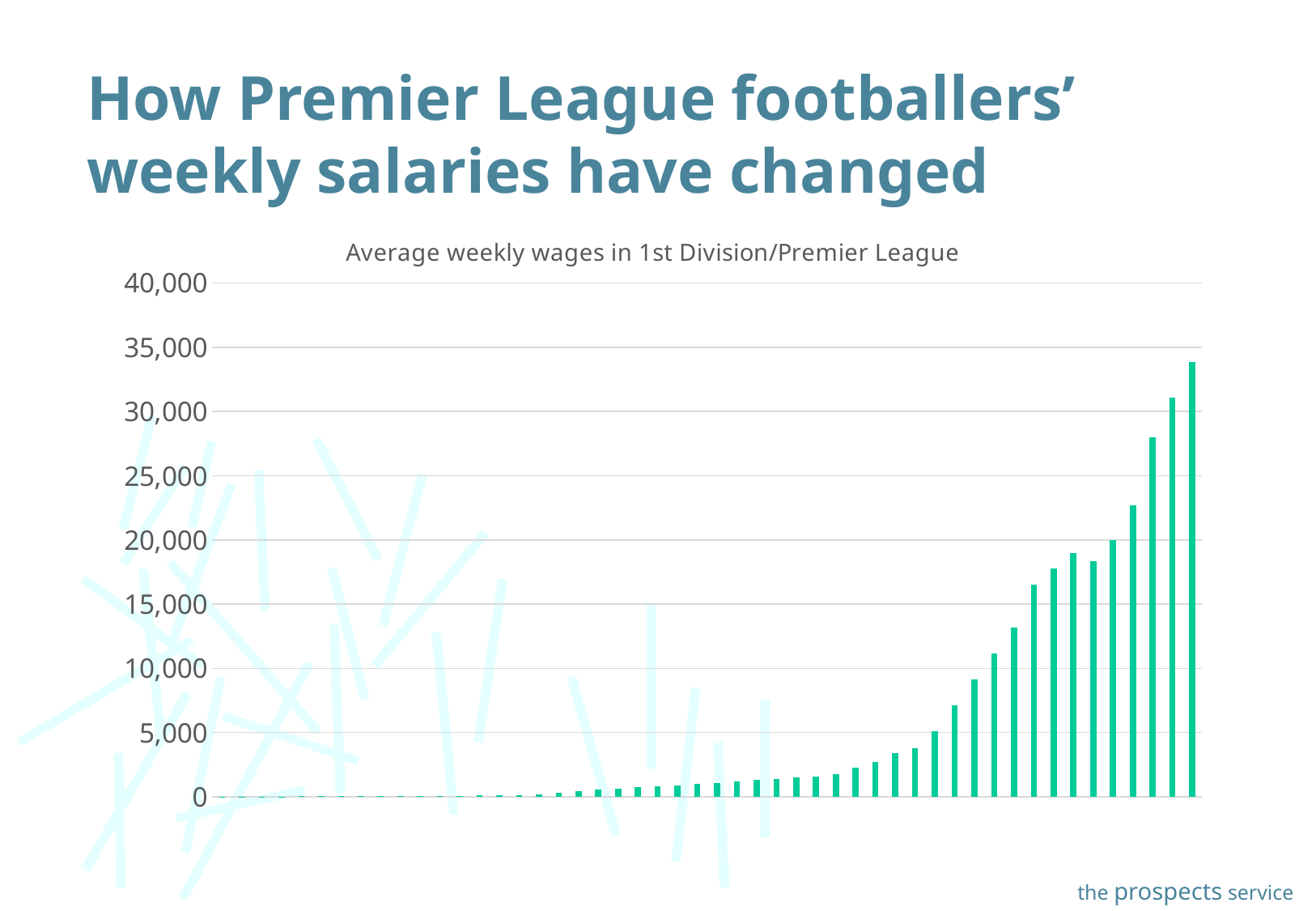
Do the values generally rise or fall from left to right along the x axis? rise What is the highest value shown on the y axis? 40,000 Is the value of the third bar from the right greater or less than 25,000? greater Is the value of the fourth bar from the right greater or less than 25,000? less Is the value of the rightmost bar greater or less than 35,000? less Which bar is the tallest: the leftmost bar or the rightmost bar? the rightmost bar Is the value of the rightmost bar larger or smaller than the value of the second bar from the right? larger What kind of chart is shown on the slide? bar chart What is the title of the chart? Average weekly wages in 1st Division/Premier League